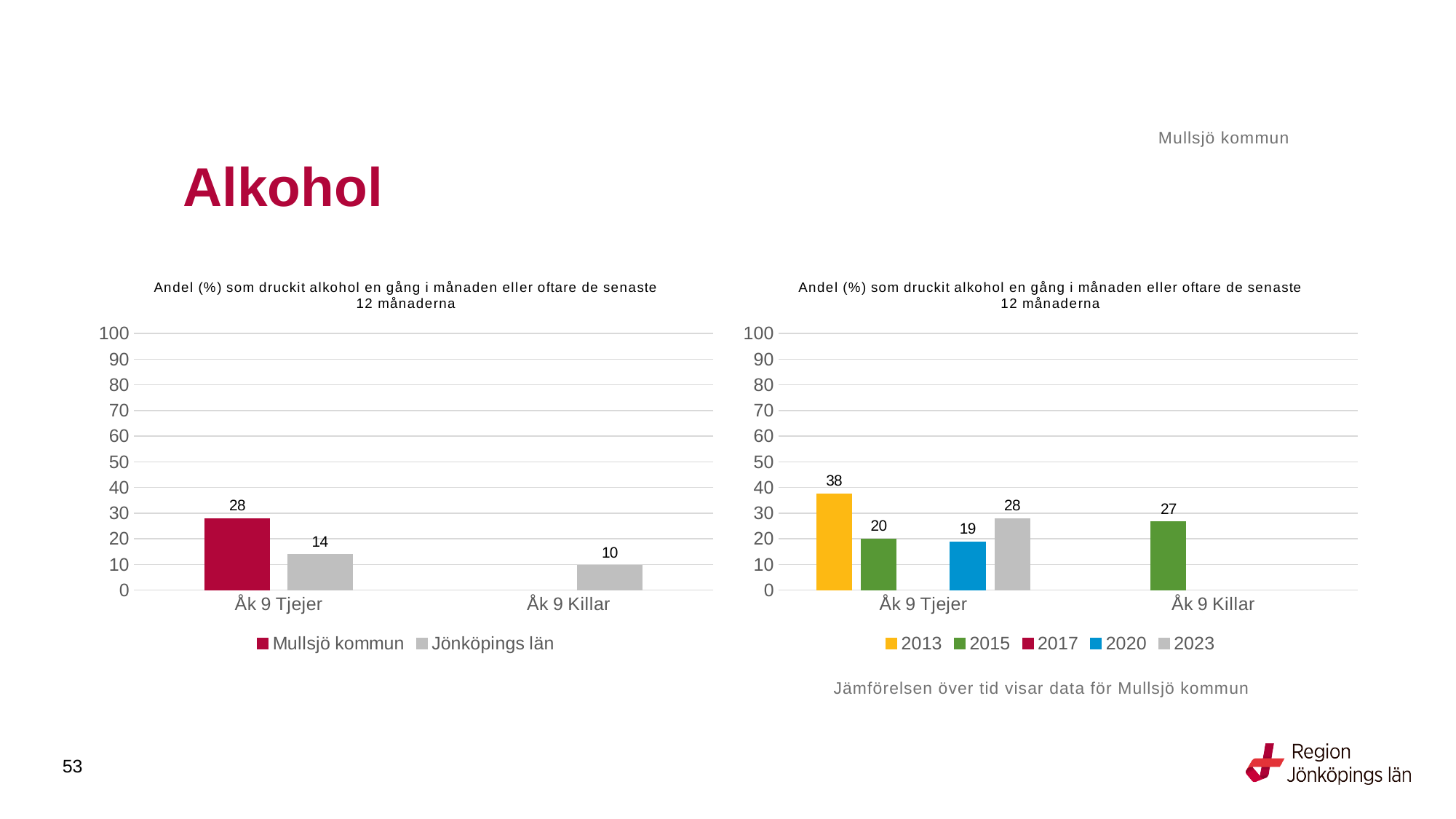
In the right chart, which year has the highest value for Åk 9 Tjejer? 2013 In the left chart, which is larger for Åk 9 Tjejer: Mullsjö kommun or Jönköpings län? Mullsjö kommun In the right chart, what is the difference between the 2013 and 2023 values for Åk 9 Tjejer? 10 In the left chart, what is the value for Mullsjö kommun for Åk 9 Tjejer? 28 In the right chart, what is the value for 2015 for Åk 9 Killar? 27 What kind of chart is the right chart? Bar chart In the left chart, what is the value for Jönköpings län for Åk 9 Killar? 10 In the left chart, what is the difference between Mullsjö kommun and Jönköpings län for Åk 9 Tjejer? 14 How many series does the legend of the left chart list? 2 In the right chart, which year has the lowest value for Åk 9 Tjejer? 2020 In the right chart, what is the value for 2013 for Åk 9 Tjejer? 38 How many series does the legend of the right chart list? 5